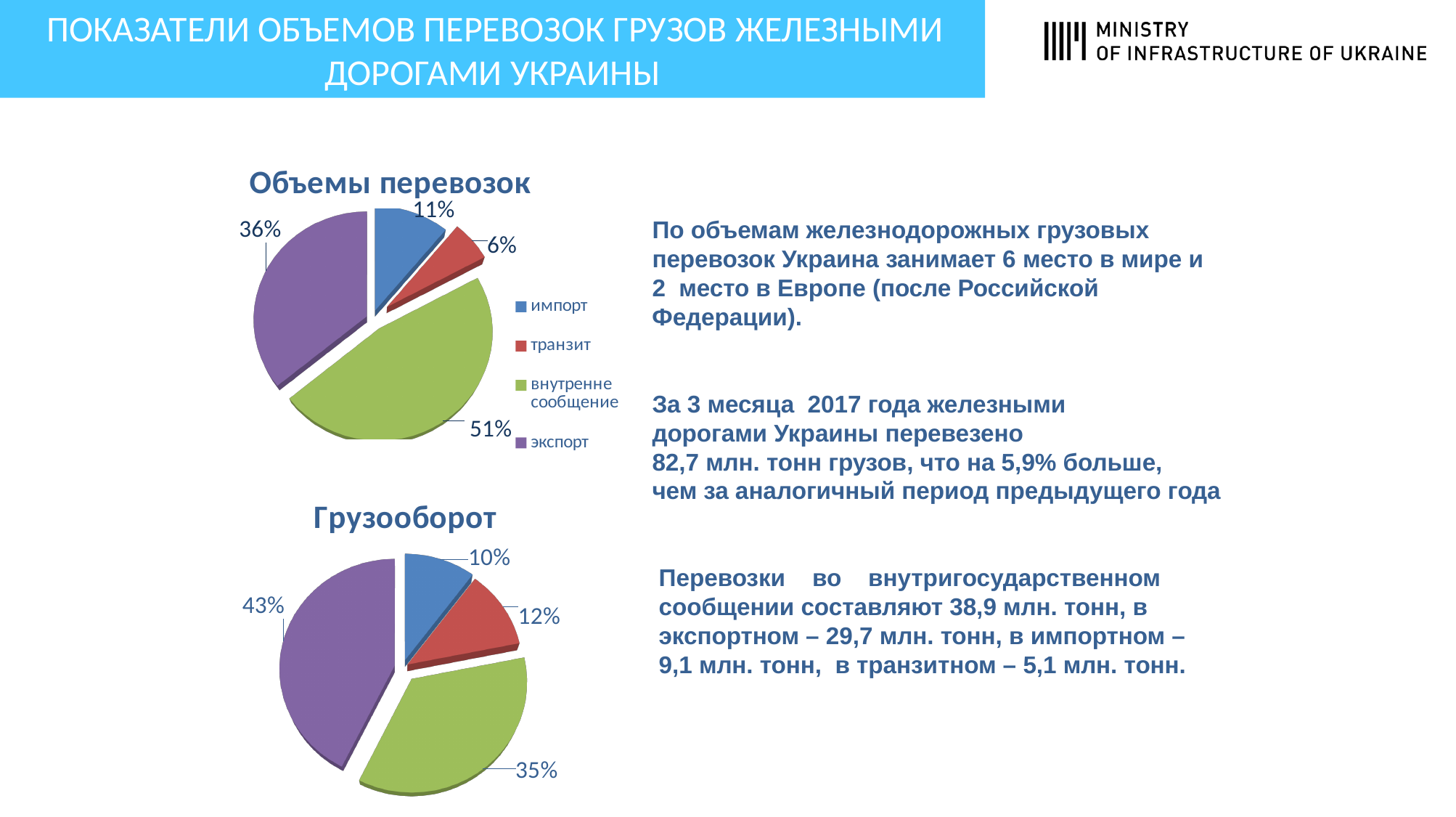
In the 'Объемы перевозок' chart, what share is labelled for экспорт? 36% In the 'Объемы перевозок' chart, what share is labelled for транзит? 6% In the 'Объемы перевозок' chart, which category has the largest slice? внутренне сообщение In the 'Грузооборот' chart, what share is labelled on the purple slice? 43% In the 'Грузооборот' chart, which is larger: the blue slice or the red slice? the red slice In the 'Объемы перевозок' chart, what is the difference in percentage points between импорт and транзит? 5 How many slices does the 'Грузооборот' pie chart have? 4 In the 'Объемы перевозок' chart, which category has the smallest slice? транзит What kind of chart is 'Грузооборот'? pie chart How many entries does the legend of the 'Объемы перевозок' chart list? 4